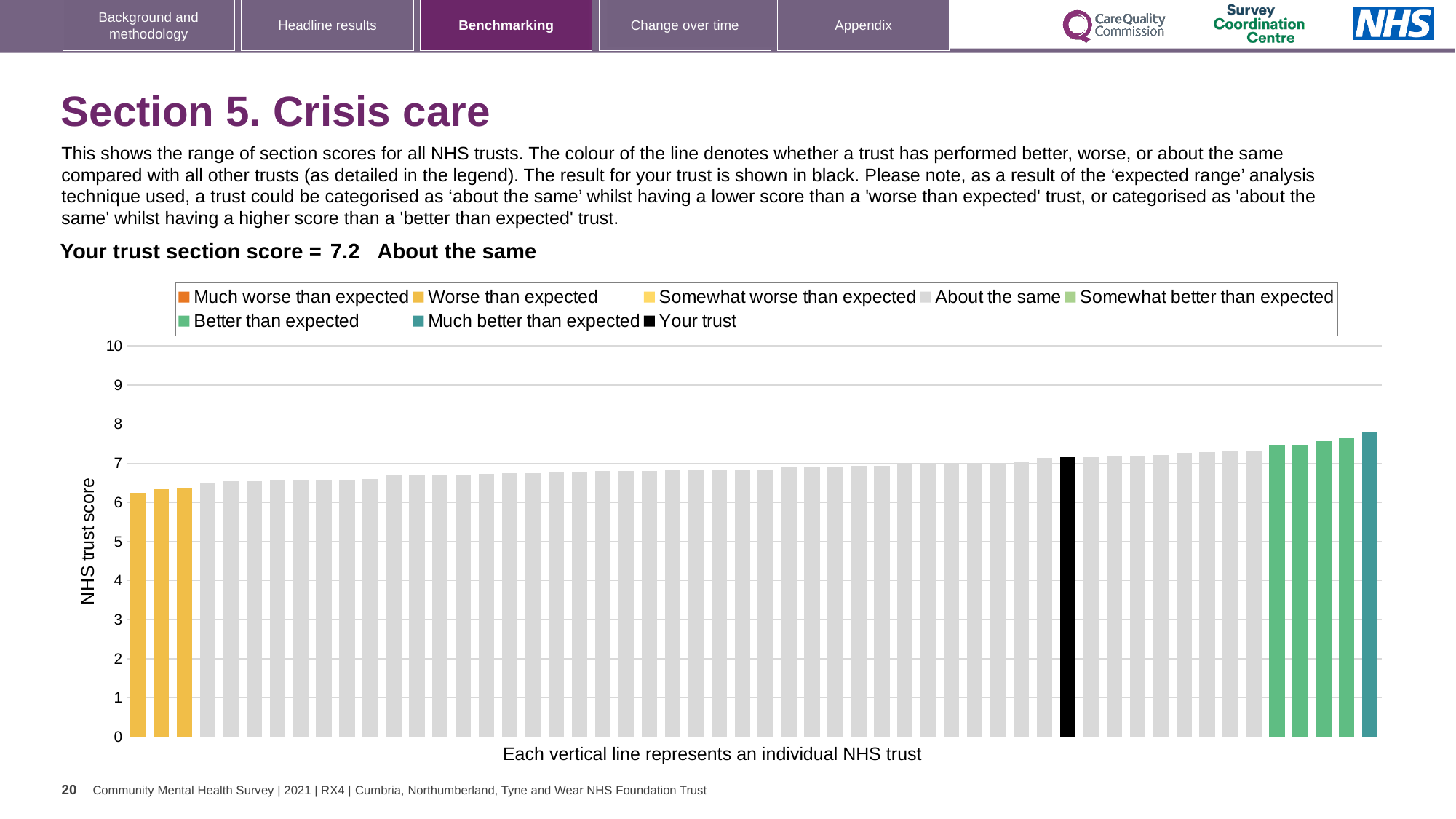
Which legend category does the highest bar on the chart belong to? Much better than expected What is the section score for your trust shown on the slide? 7.2 Which performance category is your trust placed in for Section 5 Crisis care? About the same What is the label on the vertical axis of the chart? NHS trust score Do the trust scores rise or fall moving from left to right along the x axis? rise Is the value of the lowest-scoring trust (leftmost bar) greater or less than 7? less How many entries does the chart legend list? 8 Is the value of the leftmost bar greater or less than 6? greater Is the value of the highest-scoring trust (rightmost bar) greater or less than 8? less What kind of chart is shown on the slide? bar chart Which legend category do the lowest bars on the chart belong to? Worse than expected